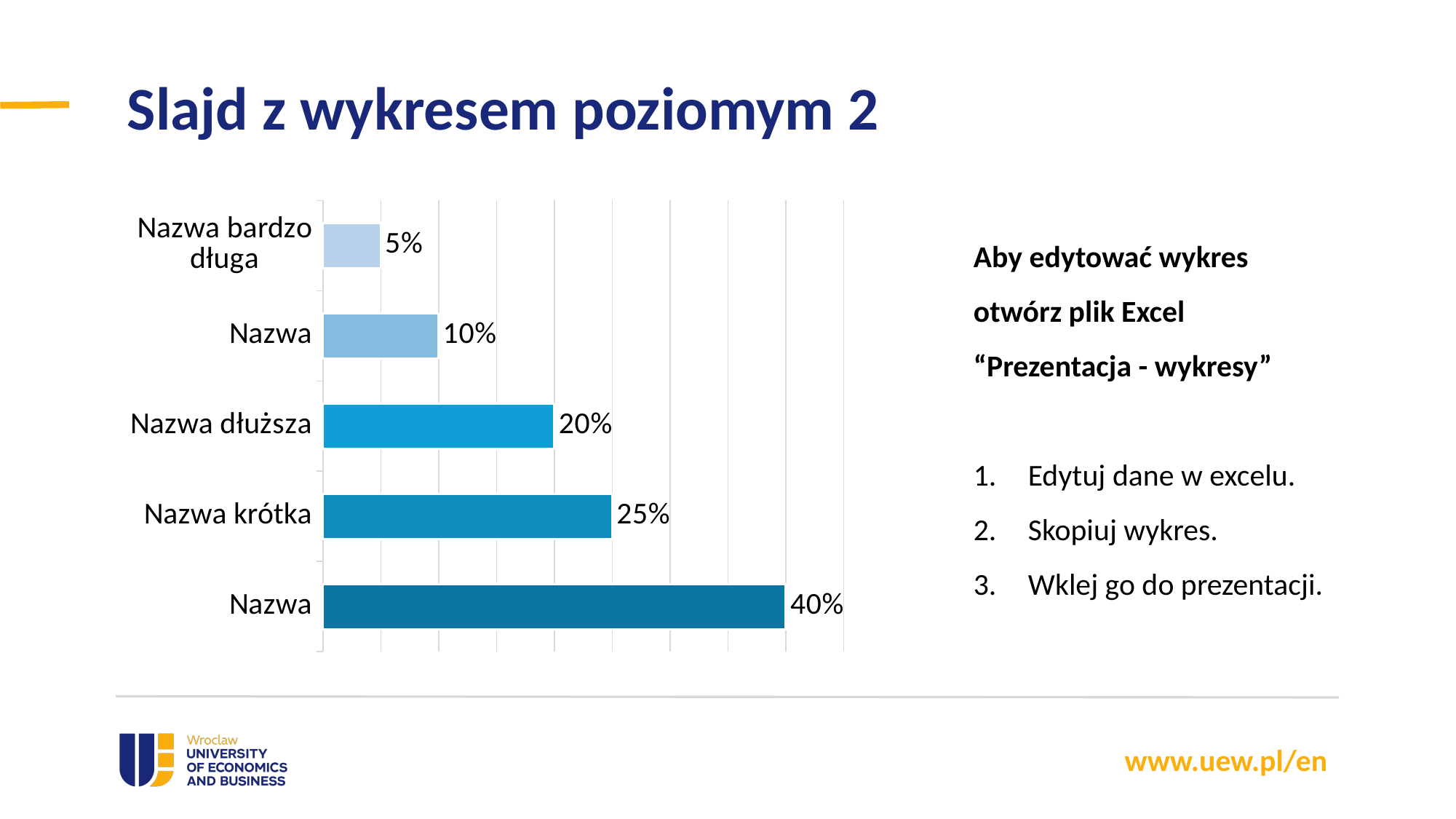
Which is larger, the value for Nazwa dłuższa or the value for Nazwa bardzo długa? Nazwa dłuższa What is the value for Nazwa bardzo długa? 5% What is the value for Nazwa dłuższa? 20% What is the difference between the values for Nazwa krótka and Nazwa dłuższa? 5% What kind of chart is shown on the slide? Bar chart Which category has the lowest value? Nazwa bardzo długa What is the value of the bottom bar, labelled Nazwa? 40% What is the difference between the bottom bar (Nazwa, 40%) and Nazwa bardzo długa? 35% What is the value of the second bar from the top, labelled Nazwa? 10% What is the value for Nazwa krótka? 25% Which category has the highest value? Nazwa (bottom bar) How many bars does the chart show? 5